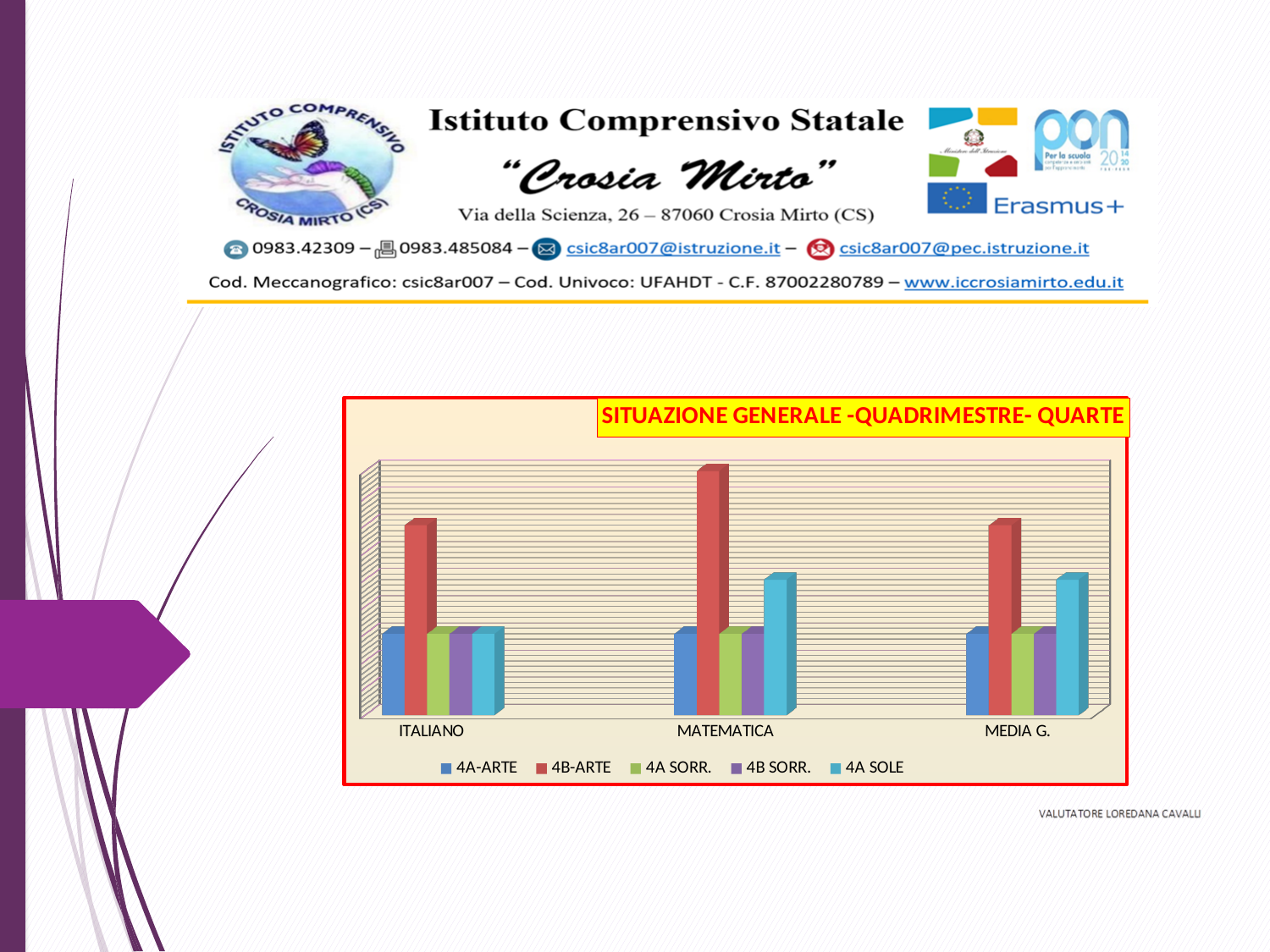
Which series has the highest bar in the ITALIANO category? 4B-ARTE In the ITALIANO category, which is larger: the bar for 4A SOLE or the bar for 4B-ARTE? 4B-ARTE How many categories are shown on the x axis of the chart? 3 What is the title of the chart? SITUAZIONE GENERALE -QUADRIMESTRE- QUARTE In the MEDIA G. category, which is larger: the bar for 4A SOLE or the bar for 4A SORR.? 4A SOLE What kind of chart is shown on the slide? Bar chart In the MATEMATICA category, which is larger: the bar for 4B-ARTE or the bar for 4A SOLE? 4B-ARTE Which series has the highest bar in the MEDIA G. category? 4B-ARTE Which category has the tallest bar for 4B-ARTE? MATEMATICA How many series does the chart legend list? 5 Which series is shown in red in the chart legend? 4B-ARTE